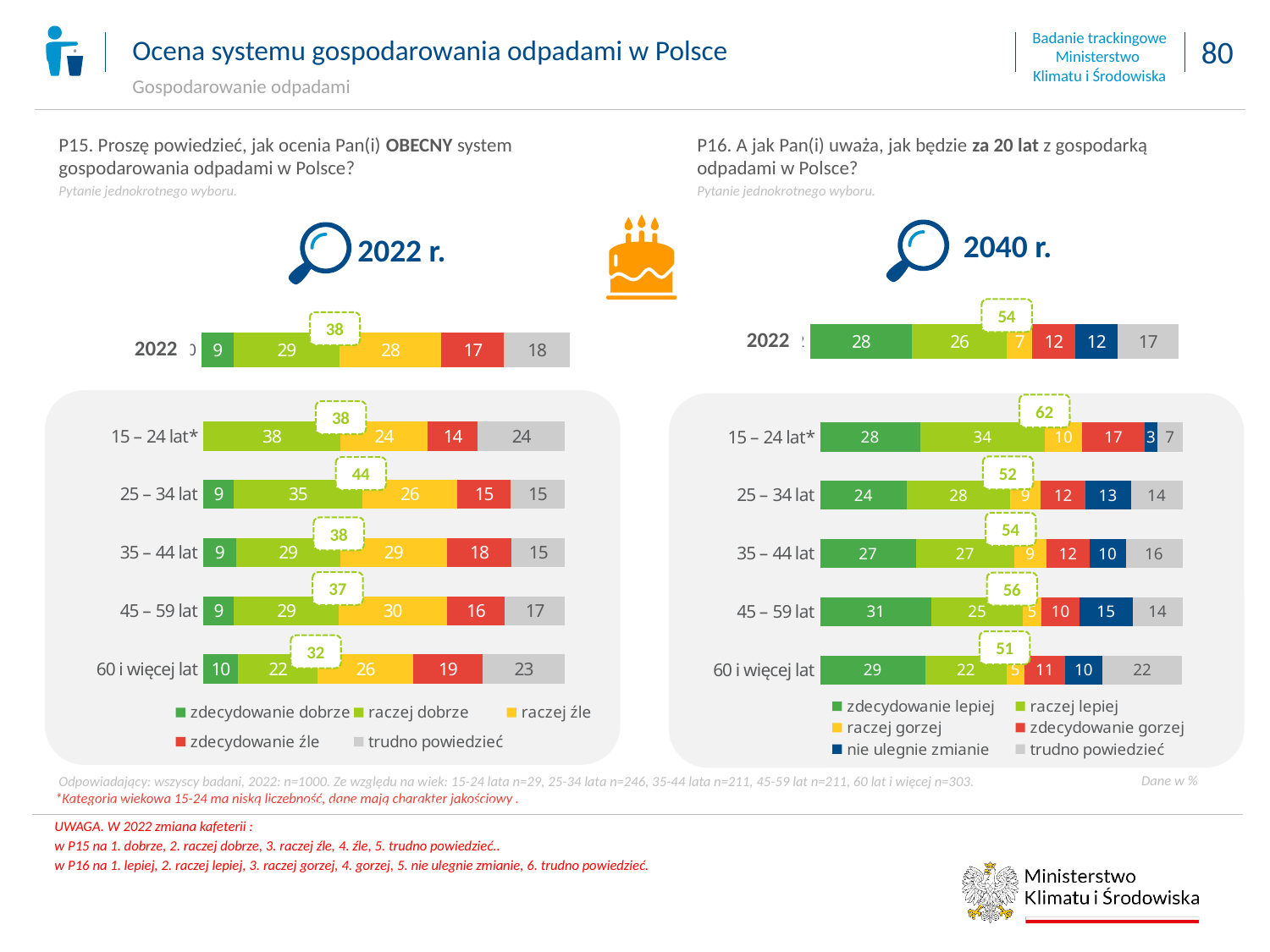
In the left chart (P15, 2022 r.), what is the difference between the 'trudno powiedzieć' values for 60 i więcej lat and 25 – 34 lat? 8 In the left chart (P15, 2022 r.), which age group has the lowest combined positive score shown in the dashed box? 60 i więcej lat In the right chart (P16, 2040 r.), what is the value for 'zdecydowanie lepiej' in the 45 – 59 lat bar? 31 In the left chart (P15, 2022 r.), what is the value for 'raczej dobrze' in the 25 – 34 lat bar? 35 In the left chart (P15, 2022 r.), what is the value for 'zdecydowanie źle' in the 2022 total bar? 17 In the right chart (P16, 2040 r.), is the 'nie ulegnie zmianie' value larger for 45 – 59 lat or for 35 – 44 lat? 45 – 59 lat How many age-group bars are shown in the left chart (P15, 2022 r.), excluding the 2022 total bar? 5 In the right chart (P16, 2040 r.), which age group has the lowest combined positive score shown in the dashed box? 60 i więcej lat In the left chart (P15, 2022 r.), which age group has the highest combined positive score shown in the dashed box? 25 – 34 lat How many series does the legend of the right chart (P16, 2040 r.) list? 6 In the right chart (P16, 2040 r.), what is the combined positive score shown in the dashed box for 15 – 24 lat? 62 What kind of chart is used on this slide? Stacked bar chart